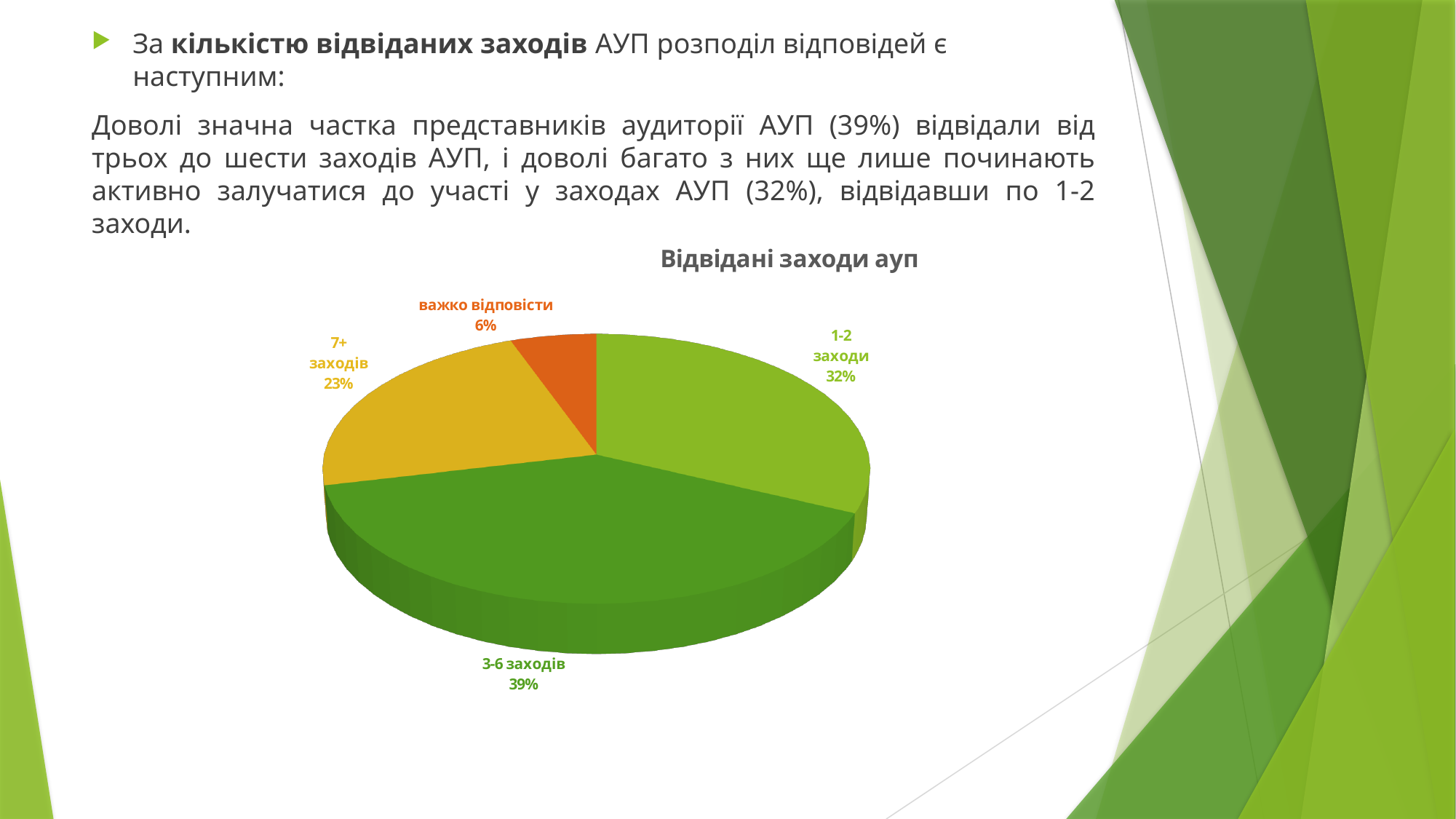
How many slices does the pie chart have? 4 Which category has the largest slice of the pie? 3-6 заходів What share of the pie does the "3-6 заходів" slice represent? 39% What is the difference in percentage points between the "3-6 заходів" and "1-2 заходи" slices? 7 What kind of chart is shown on the slide? pie chart What share of the pie does the "1-2 заходи" slice represent? 32% What share of the pie does the "7+ заходів" slice represent? 23% What colour is the "важко відповісти" slice? orange Which slice is larger: "7+ заходів" or "важко відповісти"? 7+ заходів Which category has the smallest slice of the pie? важко відповісти What is the title of the chart? Відвідані заходи ауп